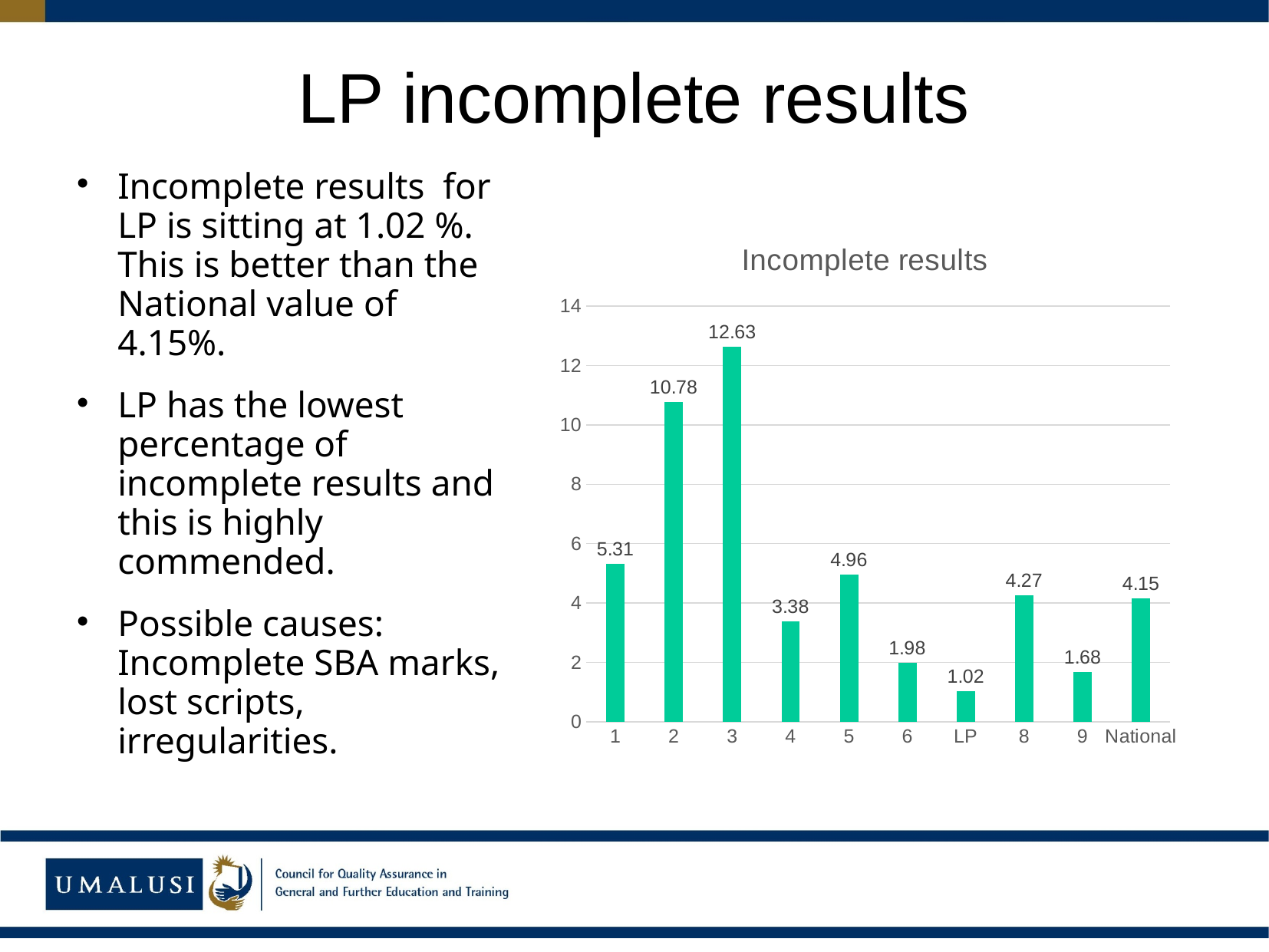
What is the title of the chart on the slide? Incomplete results Which category has the lowest value in the Incomplete results chart? LP What kind of chart is the Incomplete results chart? bar chart How many categories are shown on the x axis of the Incomplete results chart? 10 What is the value for category 3 in the Incomplete results chart? 12.63 Which is larger in the Incomplete results chart, the value for category 5 or the value for category 8? 5 What is the difference between the National value and the LP value in the Incomplete results chart? 3.13 What is the value for National in the Incomplete results chart? 4.15 What is the value for LP in the Incomplete results chart? 1.02 What is the difference between the values for category 3 and category 2 in the Incomplete results chart? 1.85 Is the value for category 2 in the Incomplete results chart greater or less than 10? greater Which category has the highest value in the Incomplete results chart? 3